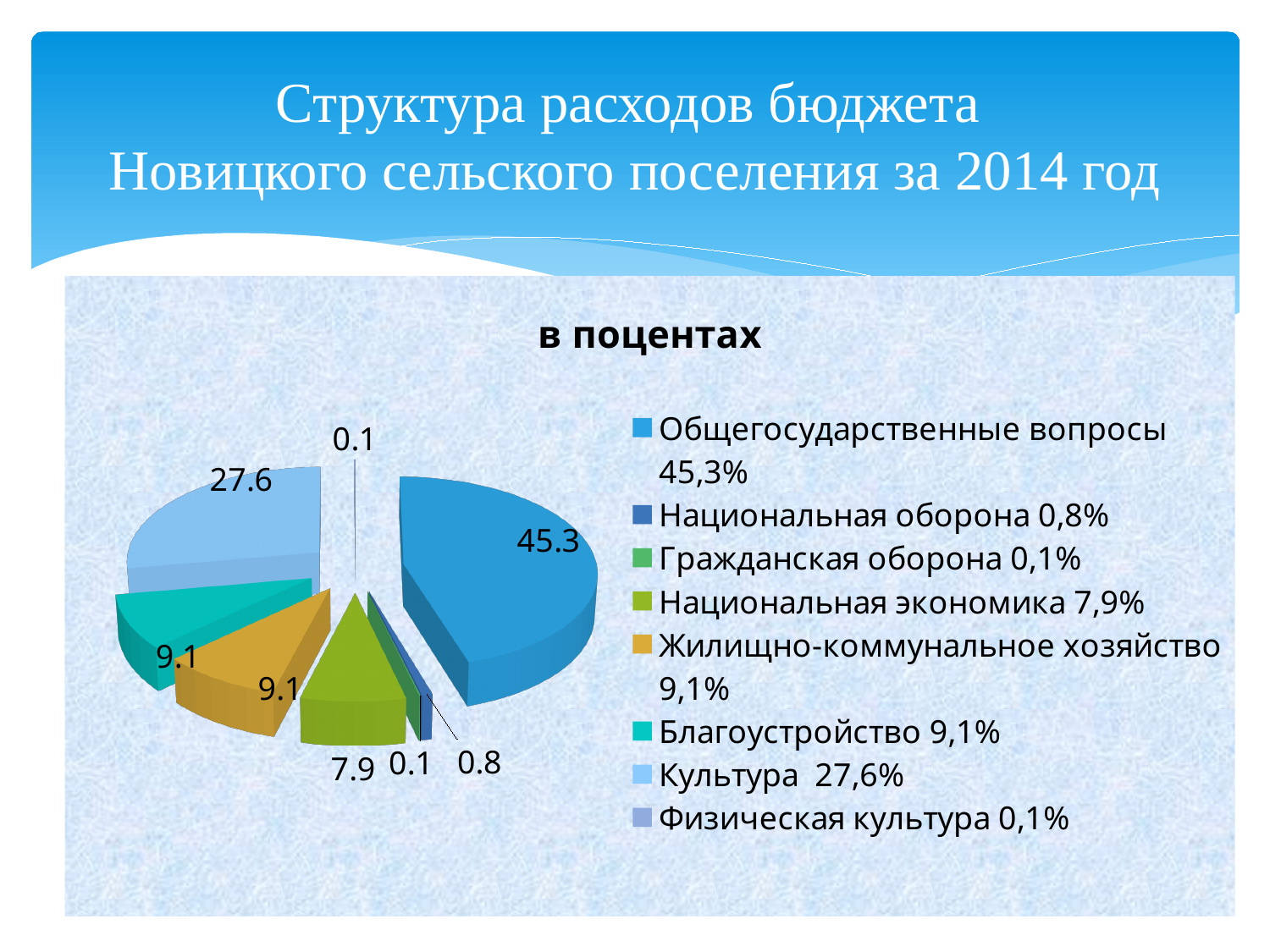
What is the value shown for Культура? 27.6 What is the value shown for Национальная экономика? 7.9 What is the value shown for Национальная оборона? 0.8 What is the value shown for Общегосударственные вопросы? 45.3 How many categories does the pie chart have? 8 Which category has the largest slice of the pie? Общегосударственные вопросы What share of the pie does Благоустройство represent? 9.1% What is the difference between the values for Общегосударственные вопросы and Культура? 17.7 Which is larger, the value for Культура or the value for Национальная экономика? Культура What kind of chart is shown on the slide? pie chart What is the title of the chart? в поцентах What is the value shown for Жилищно-коммунальное хозяйство? 9.1